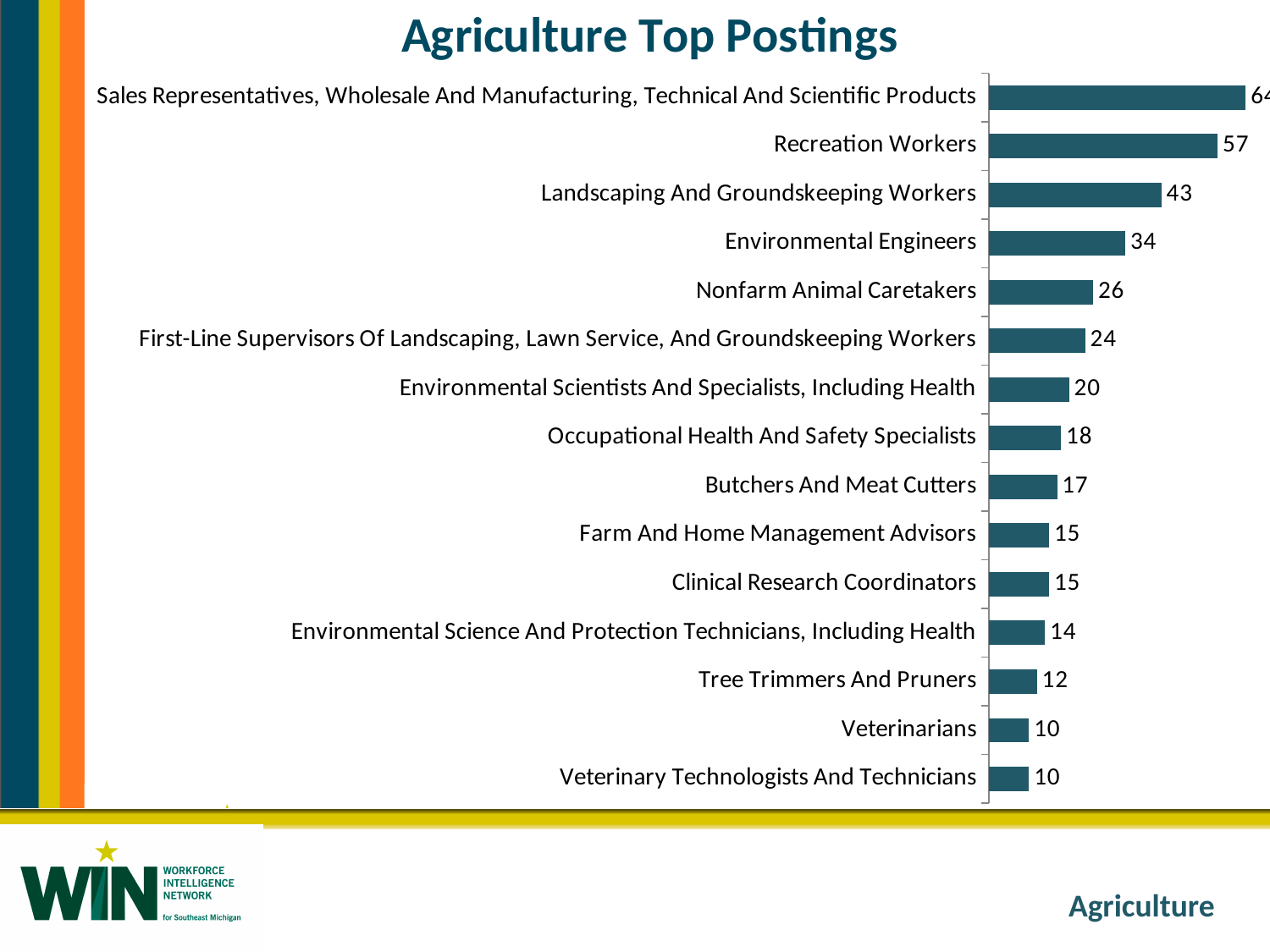
How many postings are shown for Landscaping And Groundskeeping Workers? 43 How many postings are shown for Nonfarm Animal Caretakers? 26 What is the difference in postings between Recreation Workers and Landscaping And Groundskeeping Workers? 14 How many occupations are listed in the Agriculture Top Postings chart? 15 What kind of chart is shown on the slide? bar chart What is the title of the chart? Agriculture Top Postings How many postings are shown for Tree Trimmers And Pruners? 12 Which has more postings, Environmental Engineers or Nonfarm Animal Caretakers? Environmental Engineers What is the difference in postings between Occupational Health And Safety Specialists and Butchers And Meat Cutters? 1 How many postings are shown for Environmental Engineers? 34 Which occupation has the highest number of postings? Sales Representatives, Wholesale And Manufacturing, Technical And Scientific Products How many postings are shown for Recreation Workers? 57